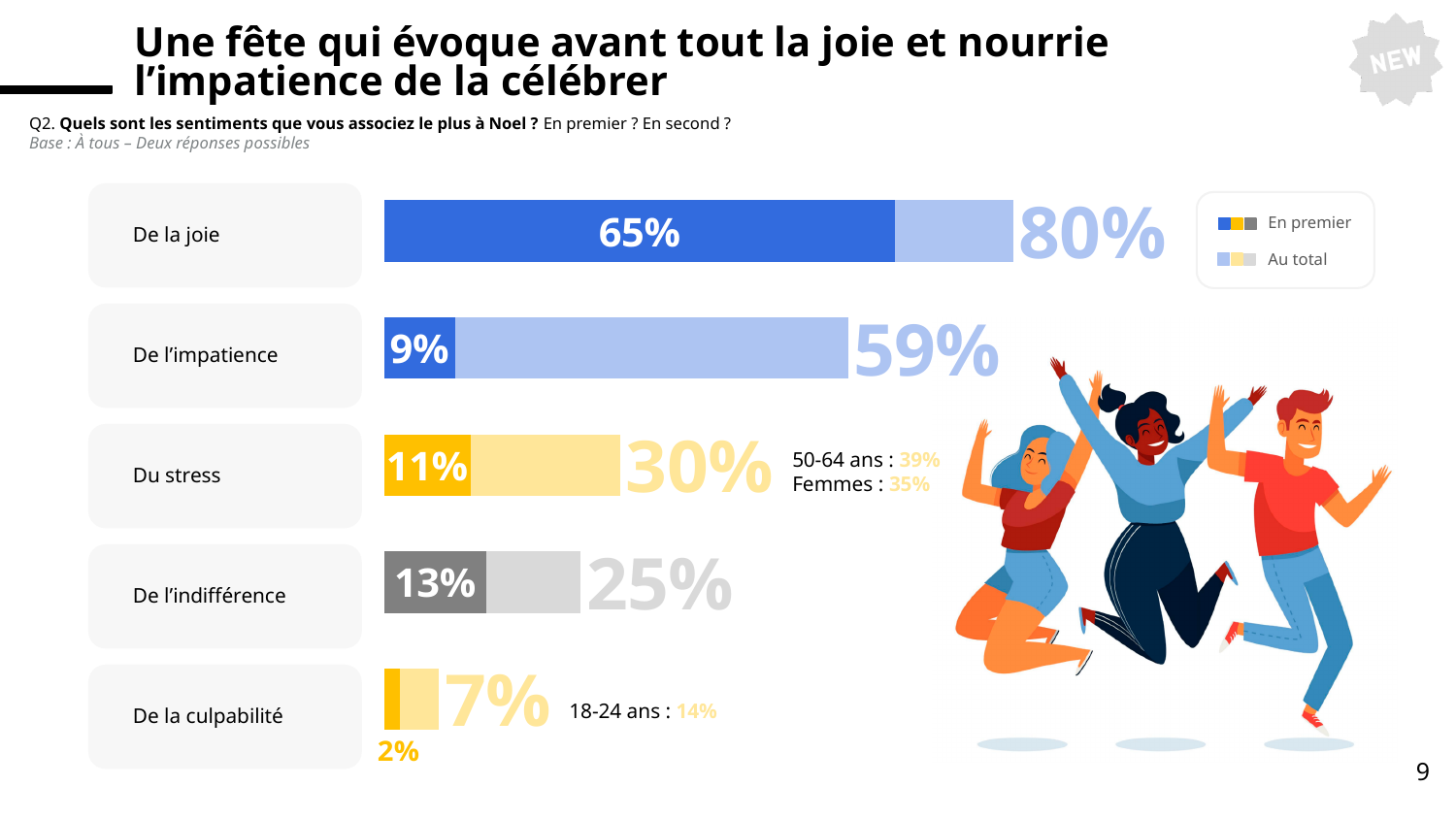
Which category has the highest 'Au total' value? De la joie What is the difference between the 'Au total' and 'En premier' values for 'De l'impatience'? 50% How many categories are shown in the chart? 5 What is the 'Au total' value for 'De la joie'? 80% Which is larger: the 'En premier' value for 'Du stress' or for 'De l'indifférence'? De l'indifférence Which category has the lowest 'En premier' value? De la culpabilité What is the 'Au total' value for 'Du stress'? 30% What kind of chart is shown on the slide? Bar chart How many series does the legend list? 2 What is the 'En premier' value for 'De l'impatience'? 9% What are the two series named in the legend? En premier, Au total What is the 'En premier' value for 'De la culpabilité'? 2%